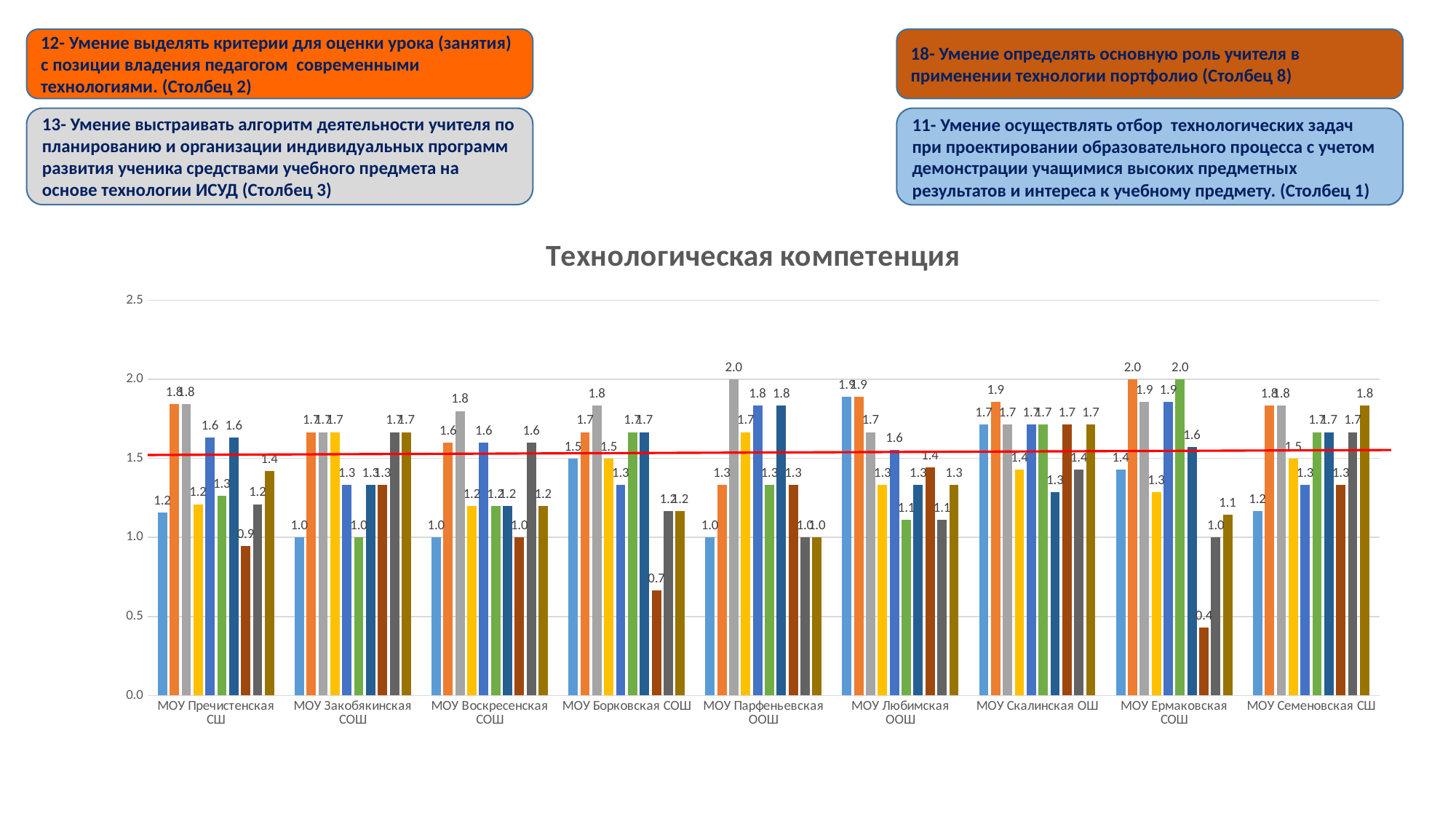
What is the highest value shown on the vertical axis of the chart? 2.5 What is the title of the chart? Технологическая компетенция Is the value of the first (light blue) bar for МОУ Парфеньевская ООШ greater or less than 1.5? less Which school has the bar with the lowest value on the chart? МОУ Ермаковская СОШ What is the value of the second (orange) bar for МОУ Ермаковская СОШ? 2.0 What is the difference between the first (light blue) bar for МОУ Любимская ООШ and the first (light blue) bar for МОУ Закобякинская СОШ? 0.9 How many schools (categories) are shown on the x axis of the chart? 9 What kind of chart is shown on the slide? bar chart What is the value of the first (light blue) bar for МОУ Любимская ООШ? 1.9 Which is larger: the first (light blue) bar for МОУ Скалинская ОШ or the first (light blue) bar for МОУ Семеновская СШ? МОУ Скалинская ОШ What is the lowest value labelled anywhere on the chart? 0.4 What is the value of the first (light blue) bar for МОУ Борковская СОШ? 1.5